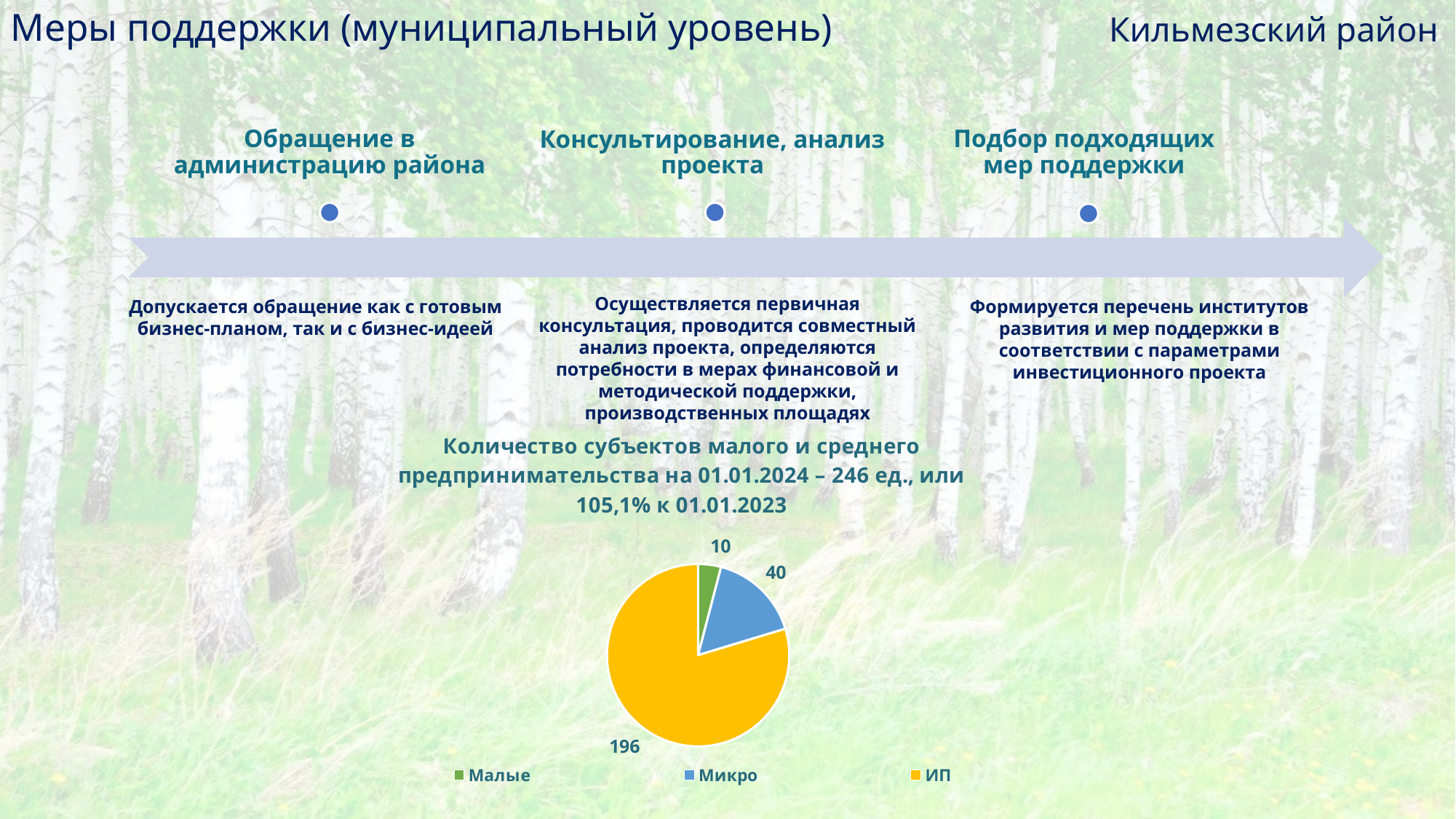
What is the value for the Малые slice of the pie chart? 10 What colour is the ИП slice in the pie chart? yellow Which is larger in the pie chart, Микро or Малые? Микро Which category has the largest slice in the pie chart? ИП What is the value for the ИП slice of the pie chart? 196 What kind of chart is shown on the slide? pie chart How many slices does the pie chart have? 3 What is the difference between the ИП value and the Микро value in the pie chart? 156 What is the difference between the Микро value and the Малые value in the pie chart? 30 Which category has the smallest slice in the pie chart? Малые What is the total of all slices in the pie chart? 246 What is the value for the Микро slice of the pie chart? 40